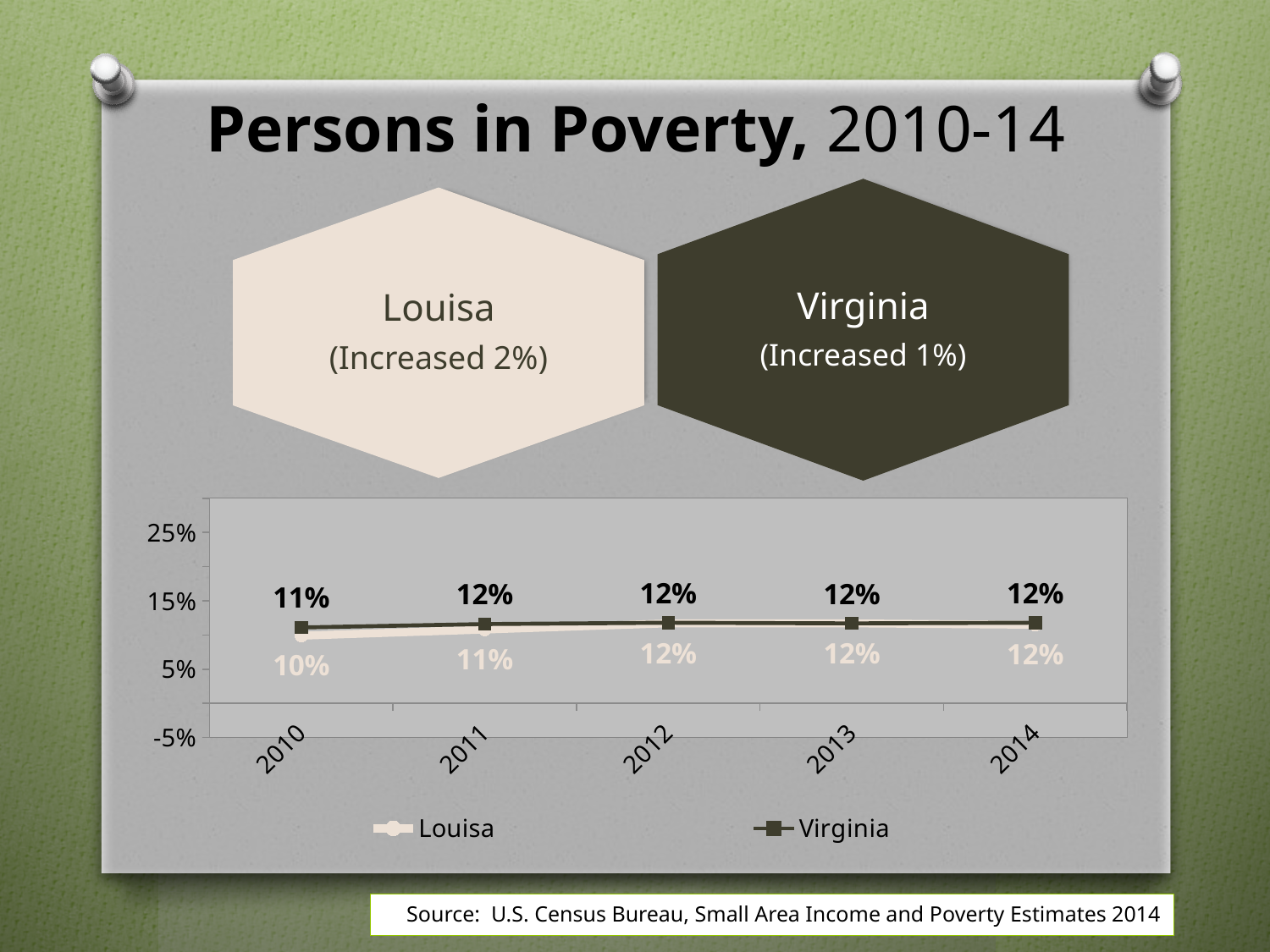
What kind of chart is shown on the slide? line chart What is the title of the chart on the slide? Persons in Poverty, 2010-14 In 2010, which had the higher poverty rate, Louisa or Virginia? Virginia How many years are plotted along the x axis? 5 Is the value for Louisa in 2014 greater or less than 15%? less What is the difference between Virginia's and Louisa's poverty rates in 2010? 1% Does Louisa's poverty rate rise or fall from 2010 to 2014? rise What was the poverty rate for Virginia in 2010? 11% What was the poverty rate for Virginia in 2014? 12% How many series does the legend list? 2 What was the poverty rate for Louisa in 2011? 11% What was the poverty rate for Louisa in 2010? 10%